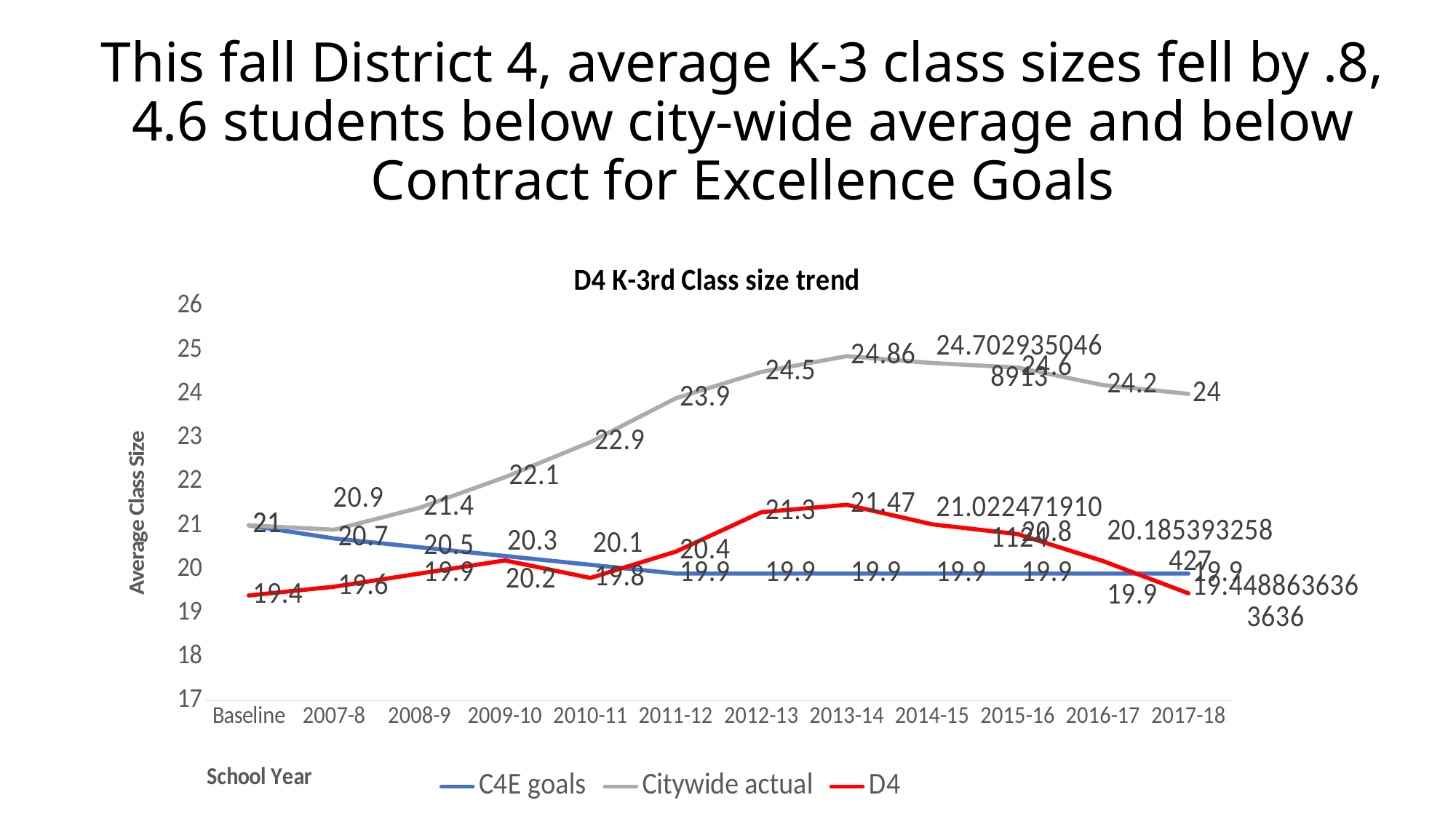
What is the D4 value at Baseline? 19.4 How many school-year categories are plotted on the x axis? 12 In which school year does the D4 series reach its highest value? 2013-14 In which school year does the Citywide actual series reach its highest value? 2013-14 How many series does the legend list? 3 What is the Citywide actual value for 2013-14? 24.86 What is the title of the chart? D4 K-3rd Class size trend What type of chart is shown on the slide? Line chart What is the difference between the Citywide actual value and the D4 value in 2013-14? 3.39 Which is larger in 2012-13, the Citywide actual value or the D4 value? Citywide actual Does the Citywide actual series rise or fall from Baseline to 2013-14? Rise What is the C4E goals value for 2007-8? 20.7